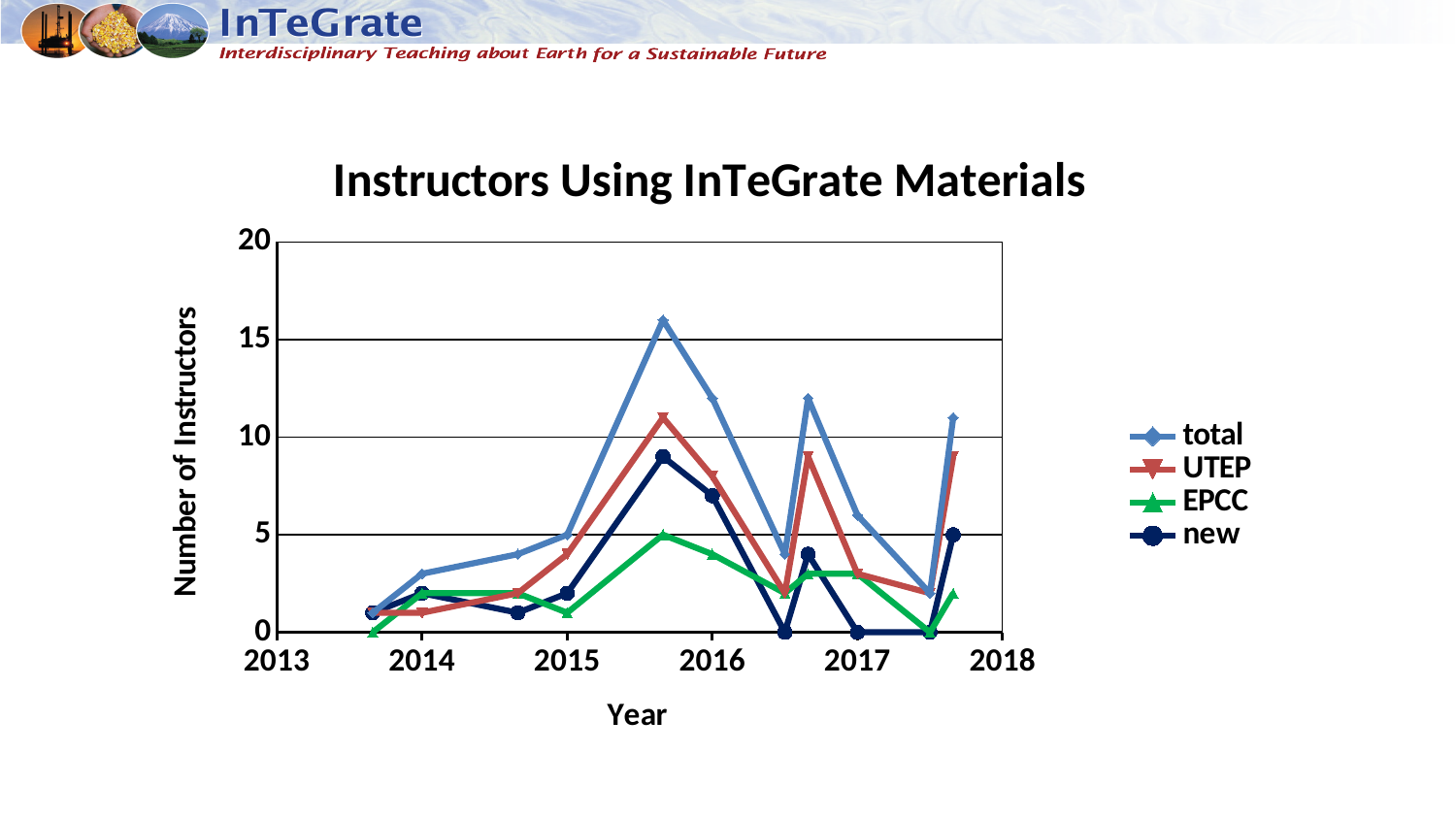
What kind of chart is shown on the slide? line chart Which series reaches the highest value on the chart? total How many series does the legend list? 4 What is the value of the total series at 2015? 5 What is the title of the chart? Instructors Using InTeGrate Materials Is the peak value of the UTEP series greater or less than 10? greater Is the peak value of the total series greater or less than 10? greater What is the value of the new series at 2017? 0 What are the four series named in the legend? total, UTEP, EPCC, new Is the highest value of the EPCC series greater or less than 10? less At 2016, which is larger, the total series or the EPCC series? total Between 2013 and 2015, does the total series rise or fall? rise